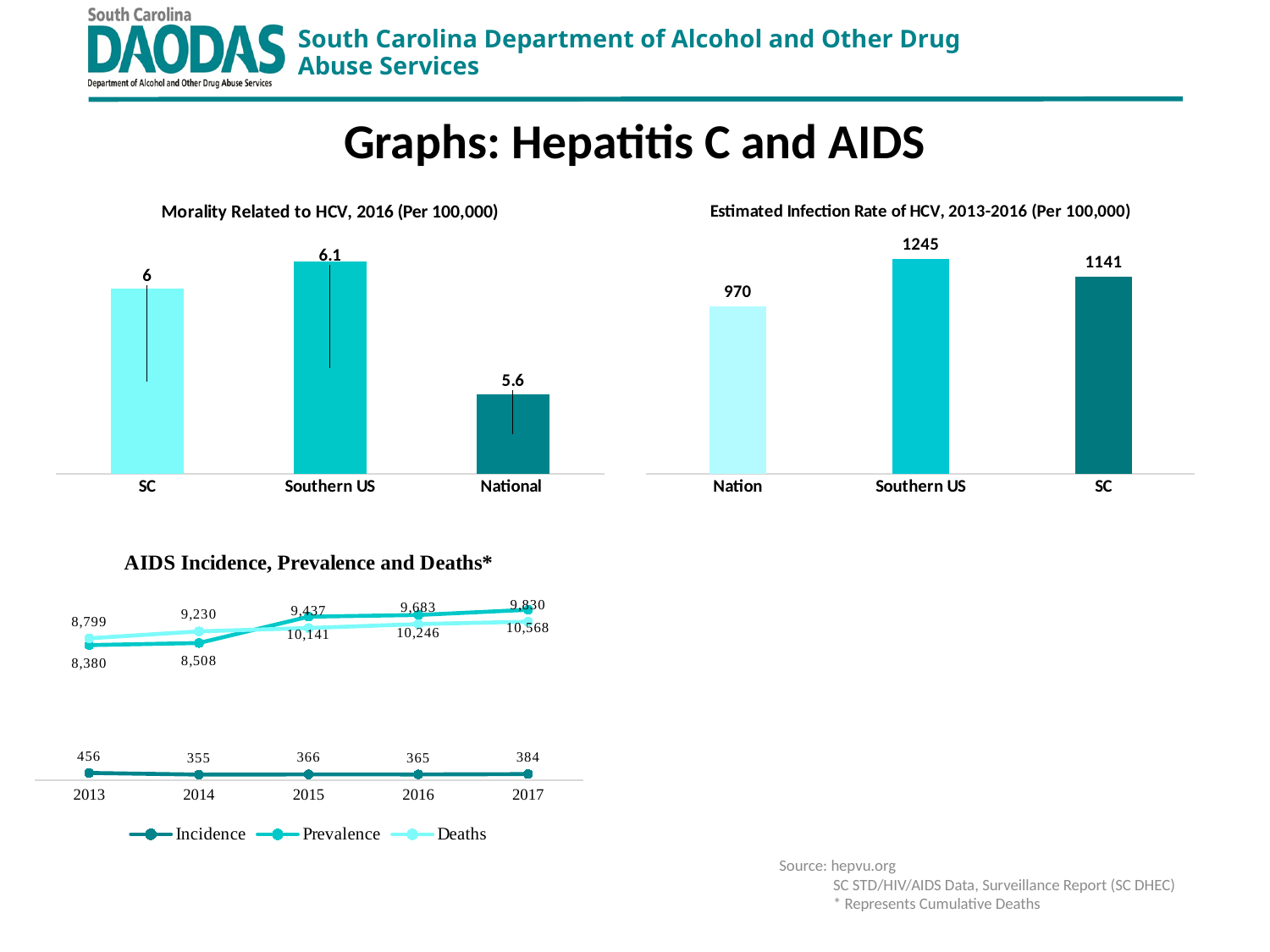
In the 'Estimated Infection Rate of HCV, 2013-2016 (Per 100,000)' chart, what is the difference between the Southern US and Nation values? 275 In the 'Estimated Infection Rate of HCV, 2013-2016 (Per 100,000)' chart, which is larger, the value for Nation or the value for SC? SC How many series does the legend of the 'AIDS Incidence, Prevalence and Deaths*' chart list? 3 In the 'Morality Related to HCV, 2016 (Per 100,000)' chart, what is the difference between the Southern US and National values? 0.5 In the 'Morality Related to HCV, 2016 (Per 100,000)' chart, what is the value for Southern US? 6.1 In the 'AIDS Incidence, Prevalence and Deaths*' chart, how many years are shown on the x axis? 5 In the 'Morality Related to HCV, 2016 (Per 100,000)' chart, which category has the lowest value? National What kind of chart is 'AIDS Incidence, Prevalence and Deaths*'? Line chart In the 'Estimated Infection Rate of HCV, 2013-2016 (Per 100,000)' chart, what is the value for SC? 1141 In the 'AIDS Incidence, Prevalence and Deaths*' chart, what is the Incidence value for 2013? 456 In the 'AIDS Incidence, Prevalence and Deaths*' chart, what is the difference between the Incidence values for 2013 and 2014? 101 In the 'Estimated Infection Rate of HCV, 2013-2016 (Per 100,000)' chart, which category has the highest value? Southern US